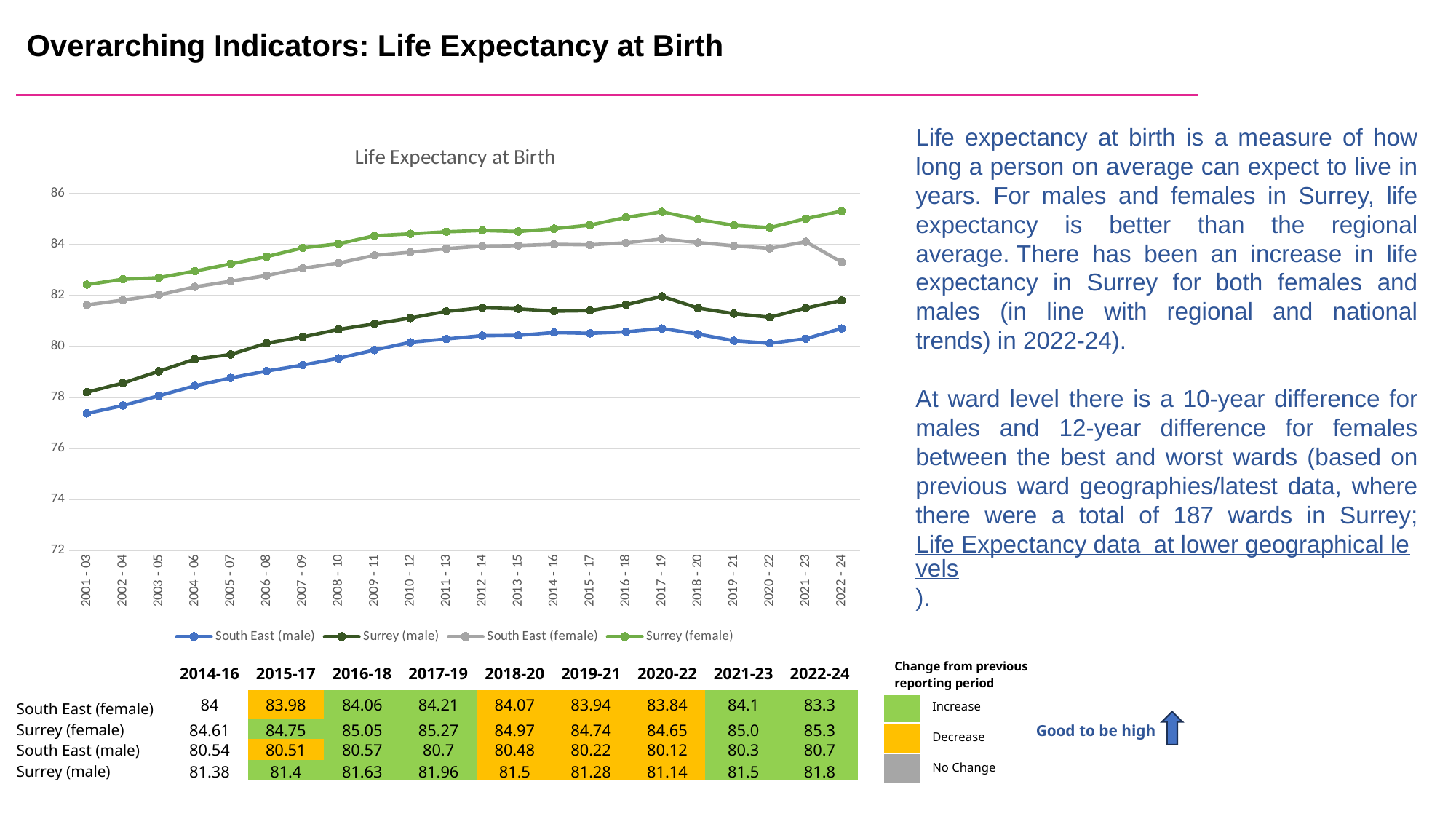
How many time periods are plotted along the x axis of the Life Expectancy at Birth chart? 22 Does the Surrey (female) line generally rise or fall from 2001-03 to 2022-24? rise Is the value for Surrey (female) in 2022-24 greater or less than 84? greater In 2022-24, how much higher is Surrey (male) life expectancy than South East (male) according to the table? 1.1 Which series has the lowest values throughout the Life Expectancy at Birth chart? South East (male) In 2017-19, which is larger: Surrey (male) or South East (male) life expectancy? Surrey (male) According to the table, what is the life expectancy for Surrey (male) in 2017-19? 81.96 According to the table, what is the life expectancy for South East (female) in 2022-24? 83.3 How many series does the legend of the Life Expectancy at Birth chart list? 4 Is the value for South East (male) in 2001-03 greater or less than 78? less What kind of chart is shown on the slide? line chart Which series has the highest values throughout the Life Expectancy at Birth chart? Surrey (female)